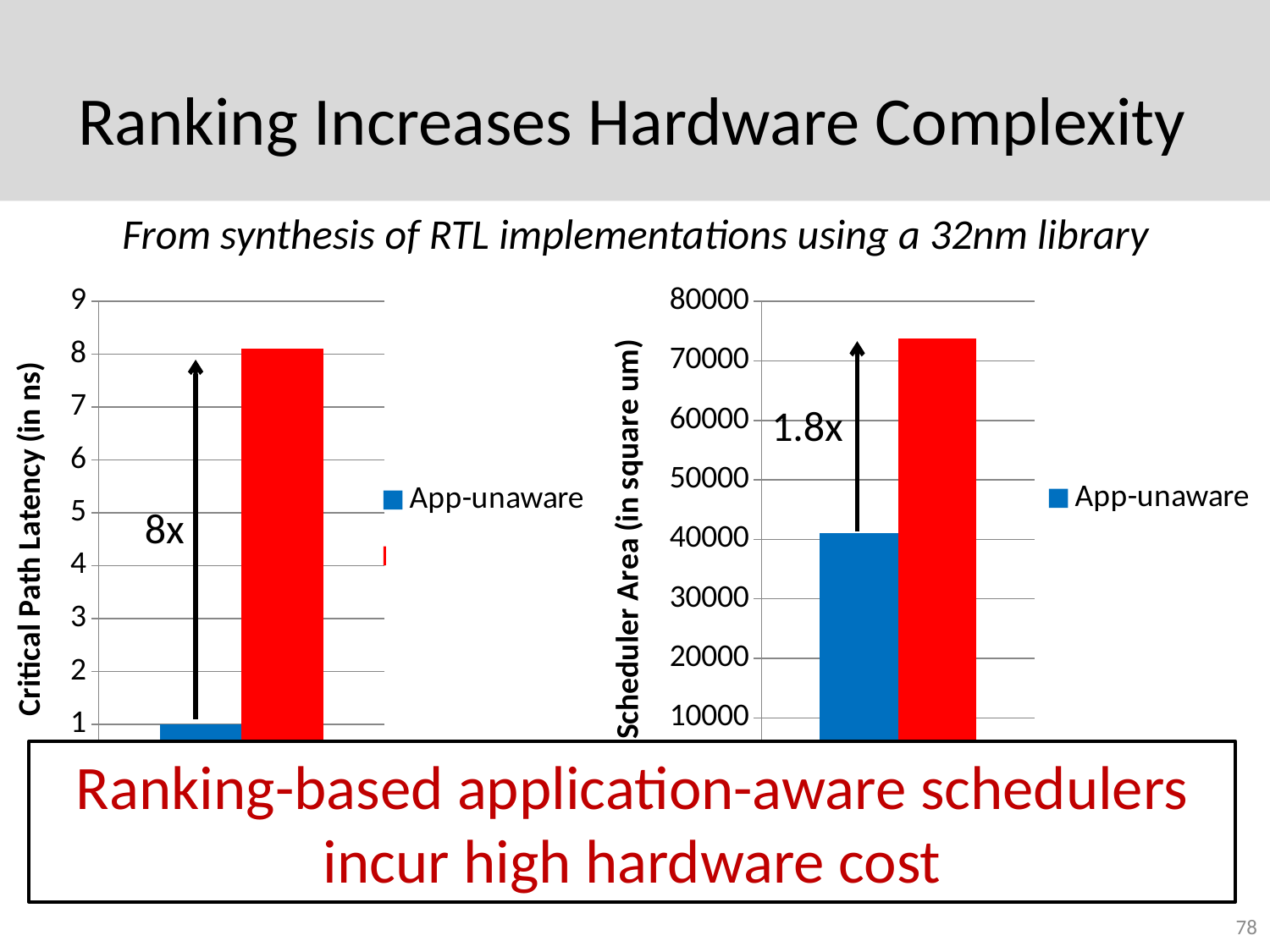
In the right chart (Scheduler Area), is the value of the red bar greater or less than 70000? greater How many bars are plotted in the left chart (Critical Path Latency)? 2 In the left chart (Critical Path Latency), is the value for App-unaware greater or less than 2? less In the right chart (Scheduler Area), which bar is taller, the blue App-unaware bar or the red bar? the red bar In the left chart (Critical Path Latency), is the value of the red bar greater or less than 7? greater In the left chart (Critical Path Latency), which bar is lower, the blue App-unaware bar or the red bar? App-unaware What kind of chart is the left chart, with the y-axis labelled Critical Path Latency (in ns)? bar chart What multiplier is annotated next to the arrow in the left chart (Critical Path Latency)? 8x What multiplier is annotated next to the arrow in the right chart (Scheduler Area)? 1.8x How many bars are plotted in the right chart (Scheduler Area)? 2